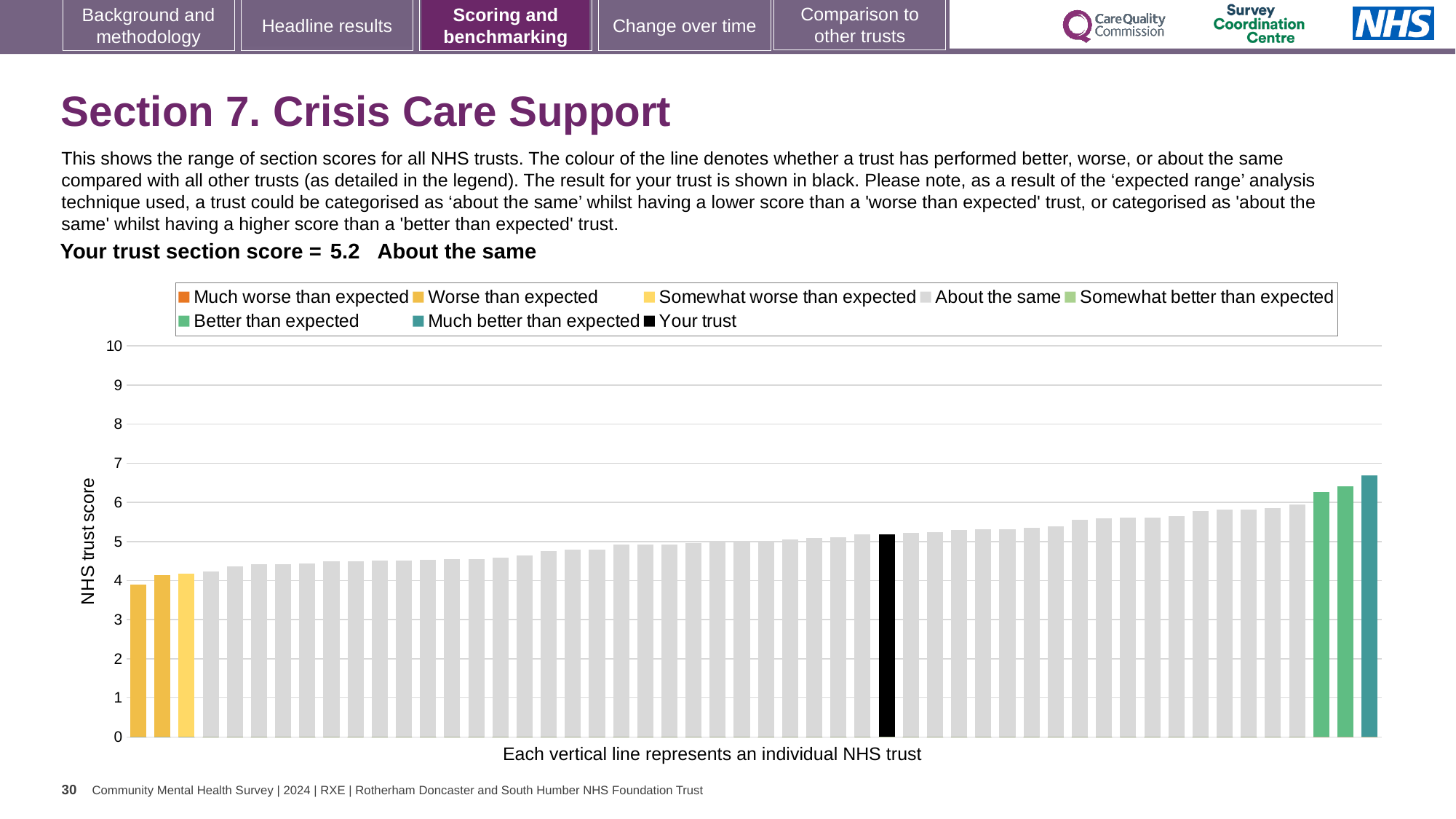
Do the bar values rise or fall from left to right along the x axis? rise Is the value of the tallest bar in the chart greater or less than 6? greater What colour is the bar representing 'Your trust' in the chart? black What is the highest value shown on the vertical axis of the chart? 10 What is the trust's section score for Crisis Care Support as printed on the slide? 5.2 Is the value of the tallest bar in the chart greater or less than 7? less What kind of chart is shown on the slide? bar chart How many entries does the chart legend list? 8 Which category is the trust's section score placed in, according to the text above the chart? About the same What is the label on the vertical axis of the chart? NHS trust score Is the value for the black 'Your trust' bar greater or less than 5? greater